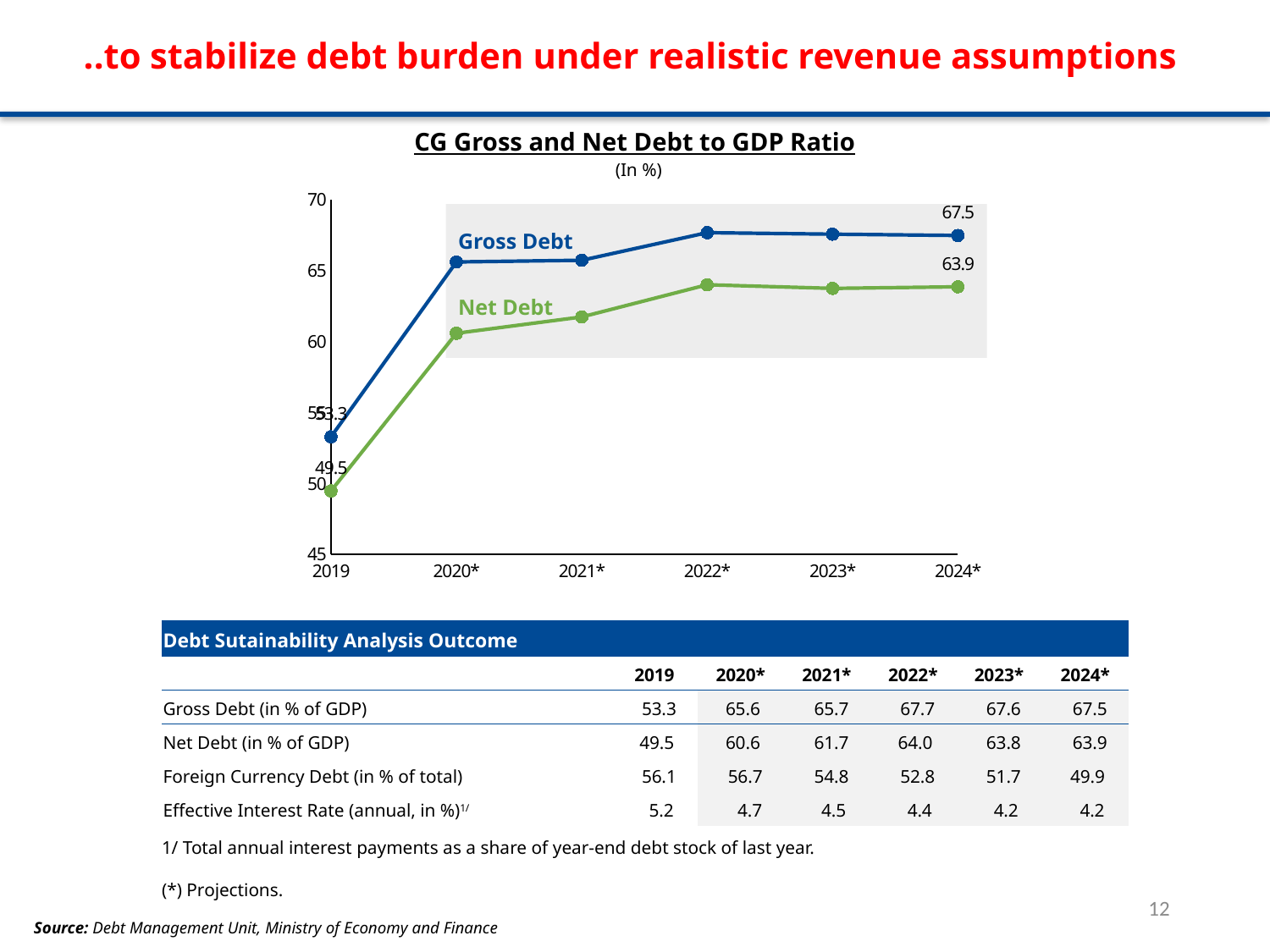
Does Gross Debt rise or fall from 2019 to 2020*? rise What is the Net Debt to GDP ratio in 2019? 49.5 What is the Gross Debt to GDP ratio in 2024*? 67.5 What is the difference between Gross Debt and Net Debt in 2024*? 3.6 Is the Net Debt value for 2021* greater or less than 65? less What kind of chart is shown on the slide? line chart Which series is higher in 2022*, Gross Debt or Net Debt? Gross Debt How many years are plotted along the x axis of the chart? 6 What is the title of the chart? CG Gross and Net Debt to GDP Ratio What is the Gross Debt to GDP ratio in 2019? 53.3 How many series does the chart show? 2 What is the Net Debt to GDP ratio in 2024*? 63.9